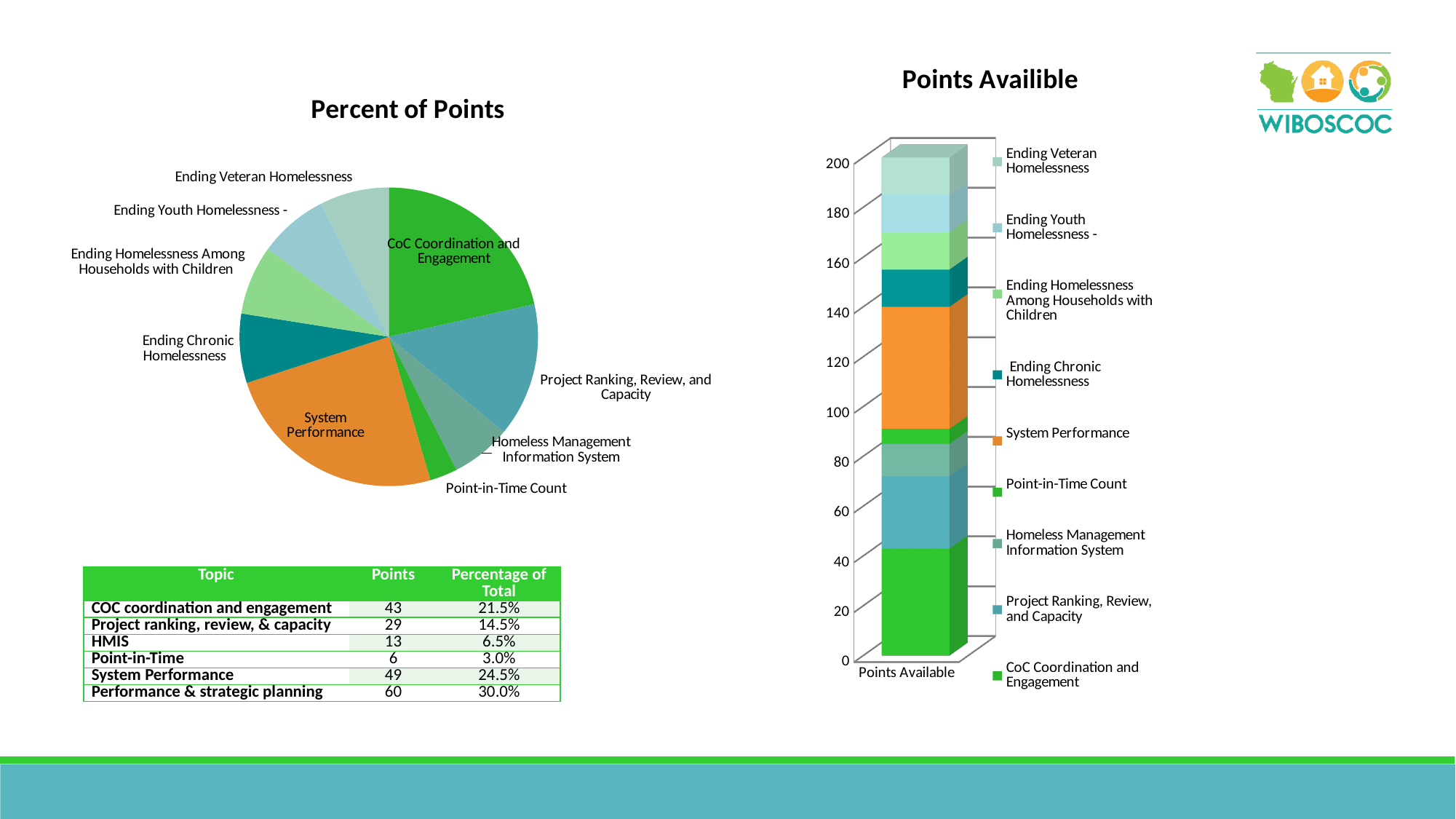
In the 'Percent of Points' pie chart, which category has the largest slice? System Performance What is the label on the category axis of the 'Points Availible' chart? Points Available In the 'Points Availible' chart, is the top of the System Performance segment greater or less than 120? greater In the 'Points Availible' chart, which segment is larger: Ending Chronic Homelessness or Point-in-Time Count? Ending Chronic Homelessness What kind of chart is the 'Points Availible' chart on the right? bar chart What kind of chart is the 'Percent of Points' chart on the left? pie chart In the 'Points Availible' chart, is the top of the CoC Coordination and Engagement segment greater or less than 60? less How many slices does the 'Percent of Points' pie chart have? 9 How many entries does the legend of the 'Points Availible' chart list? 9 In the 'Points Availible' chart, what is the total height of the stacked bar? 200 In the 'Percent of Points' pie chart, which slice is larger: Project Ranking, Review, and Capacity or Homeless Management Information System? Project Ranking, Review, and Capacity In the 'Percent of Points' pie chart, which category has the smallest slice? Point-in-Time Count